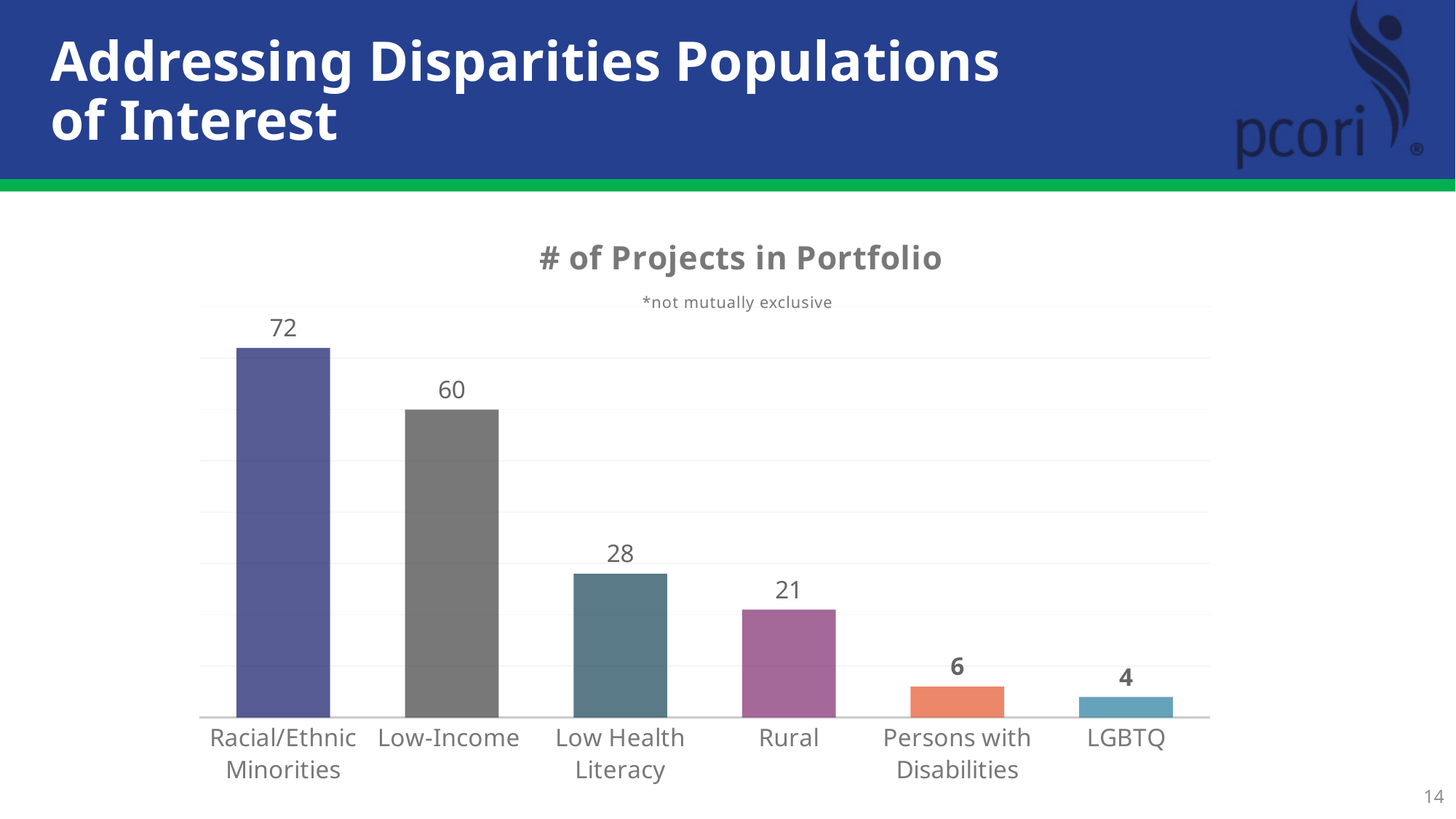
What is the number of projects for Persons with Disabilities? 6 Which population has the highest number of projects in the portfolio? Racial/Ethnic Minorities How many population categories are shown in the chart? 6 What is the title of the chart? # of Projects in Portfolio What is the number of projects for Rural? 21 Which population has the lowest number of projects in the portfolio? LGBTQ How many projects in the portfolio address Racial/Ethnic Minorities? 72 What type of chart is shown on the slide? Bar chart What is the difference in number of projects between Racial/Ethnic Minorities and Low-Income? 12 Which has more projects, Low Health Literacy or Rural? Low Health Literacy What is the number of projects for Low Health Literacy? 28 What is the number of projects for Low-Income? 60